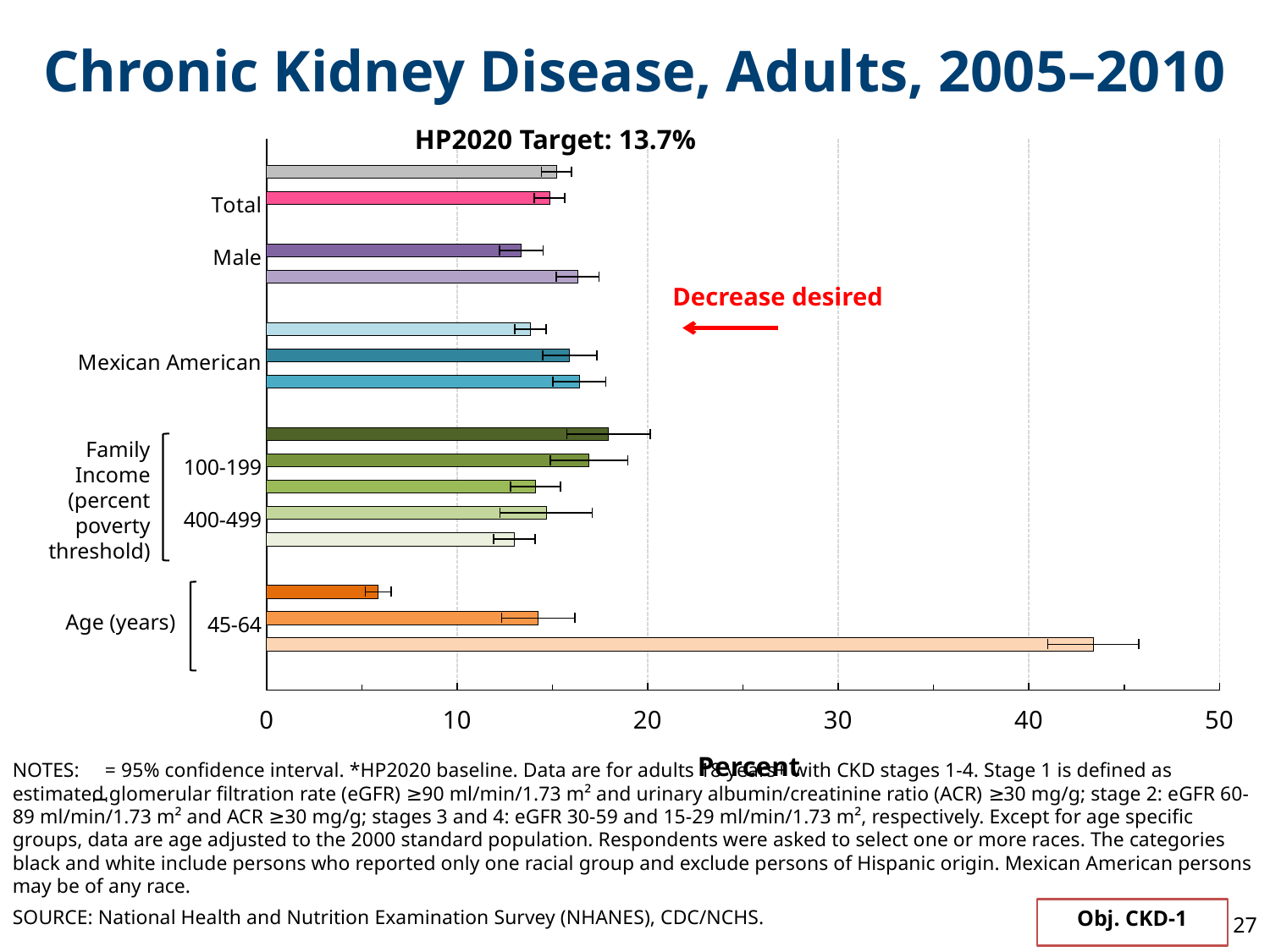
Is the value for the 400-499 family income group greater or less than 20? less What is the label of the horizontal axis? Percent What kind of chart is shown on the slide? bar chart Which has the larger value, Male or Mexican American? Mexican American Is the value for Total greater or less than 10? greater What is the HP2020 Target shown on the chart? 13.7% How many bars are plotted on the chart? 15 Is the value for the 100-199 family income group greater or less than 10? greater